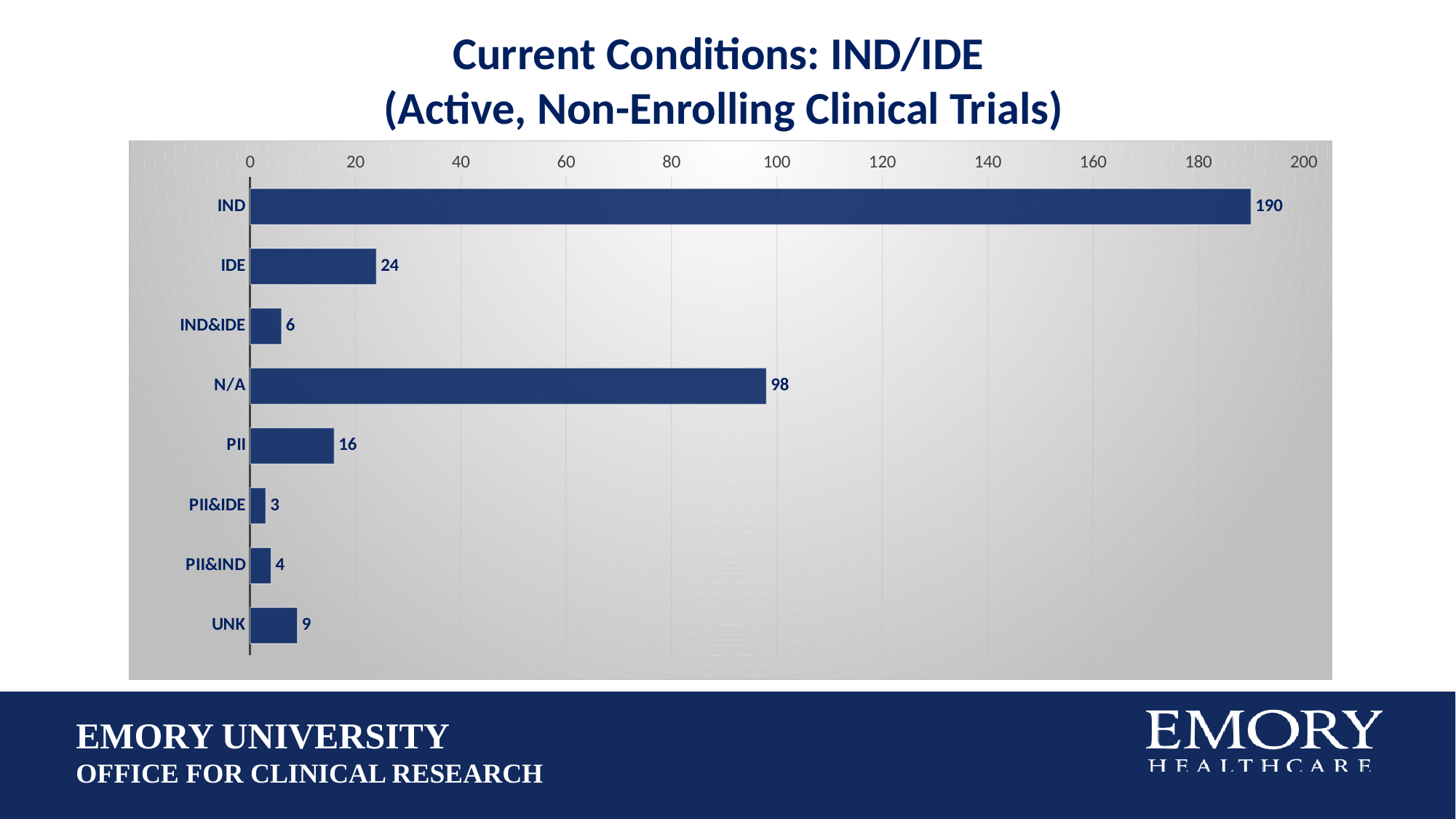
How many categories are shown in the chart? 8 What is the difference between the values for IDE and PII? 8 What kind of chart is shown on the slide? Bar chart What is the value for IND? 190 Which category has the highest value? IND What is the value for PII? 16 What is the difference between the values for IND and N/A? 92 Which is larger, the value for IND&IDE or the value for UNK? UNK Which category has the lowest value? PII&IDE What is the value for UNK? 9 What is the value for N/A? 98 What is the title of the chart? Current Conditions: IND/IDE (Active, Non-Enrolling Clinical Trials)